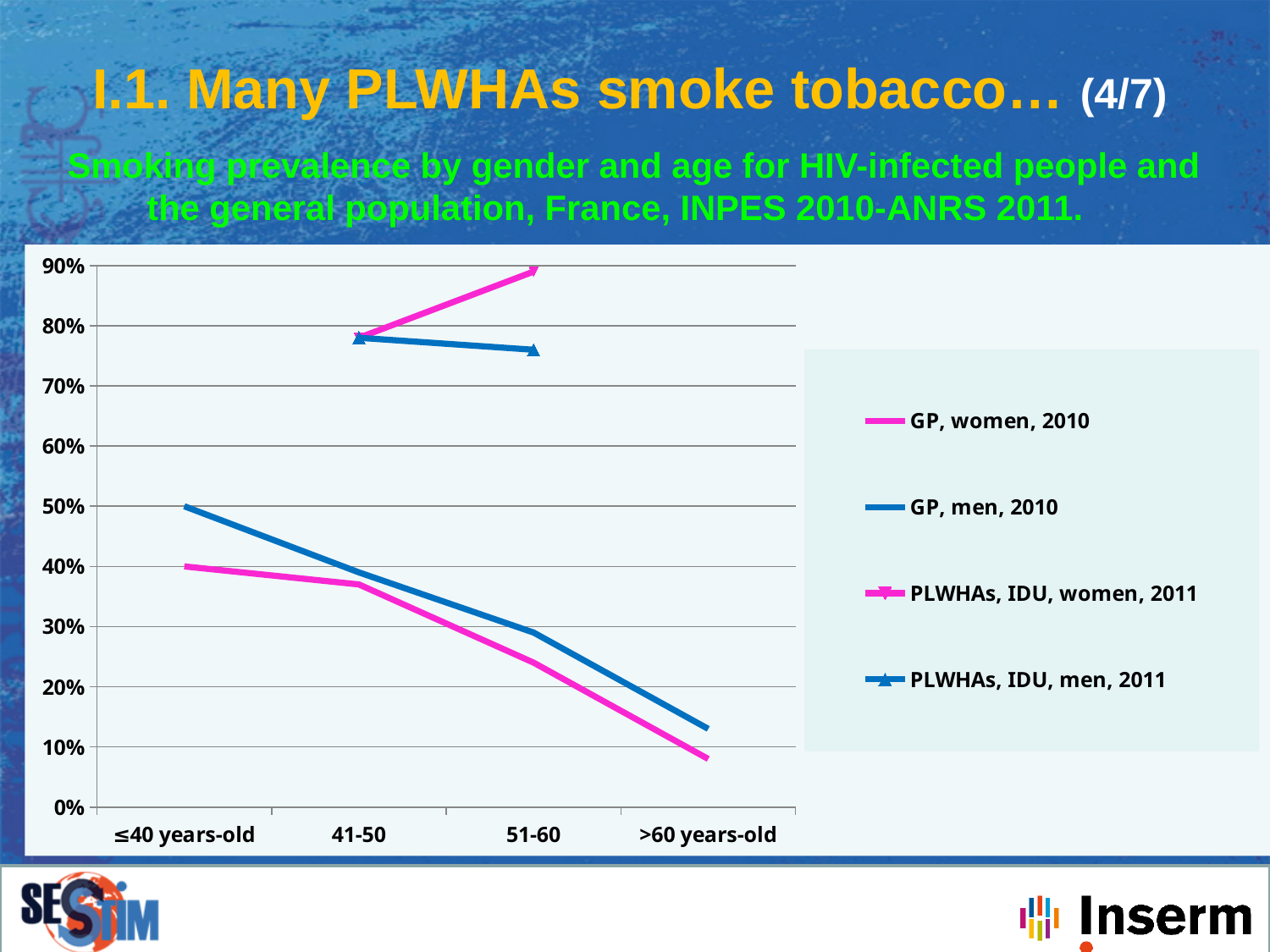
What kind of chart is shown on the slide? line chart What is the difference between GP, men, 2010 and GP, women, 2010 in the ≤40 years-old group? 10 percentage points How many series does the legend list? 4 Is the value for GP, men, 2010 in the >60 years-old group greater or less than 20%? less Which series has the highest value in the 51-60 age group? PLWHAs, IDU, women, 2011 In the ≤40 years-old group, which is larger: GP, men, 2010 or GP, women, 2010? GP, men, 2010 What is the smoking prevalence for GP, women, 2010 in the ≤40 years-old group? 40% Do the values for GP, men, 2010 rise or fall as age increases along the x axis? fall Is the value for PLWHAs, IDU, men, 2011 in the 51-60 group greater or less than 70%? greater Is the value for PLWHAs, IDU, women, 2011 in the 51-60 group greater or less than 80%? greater What is the smoking prevalence for GP, men, 2010 in the ≤40 years-old group? 50% How many age categories are shown on the x axis? 4